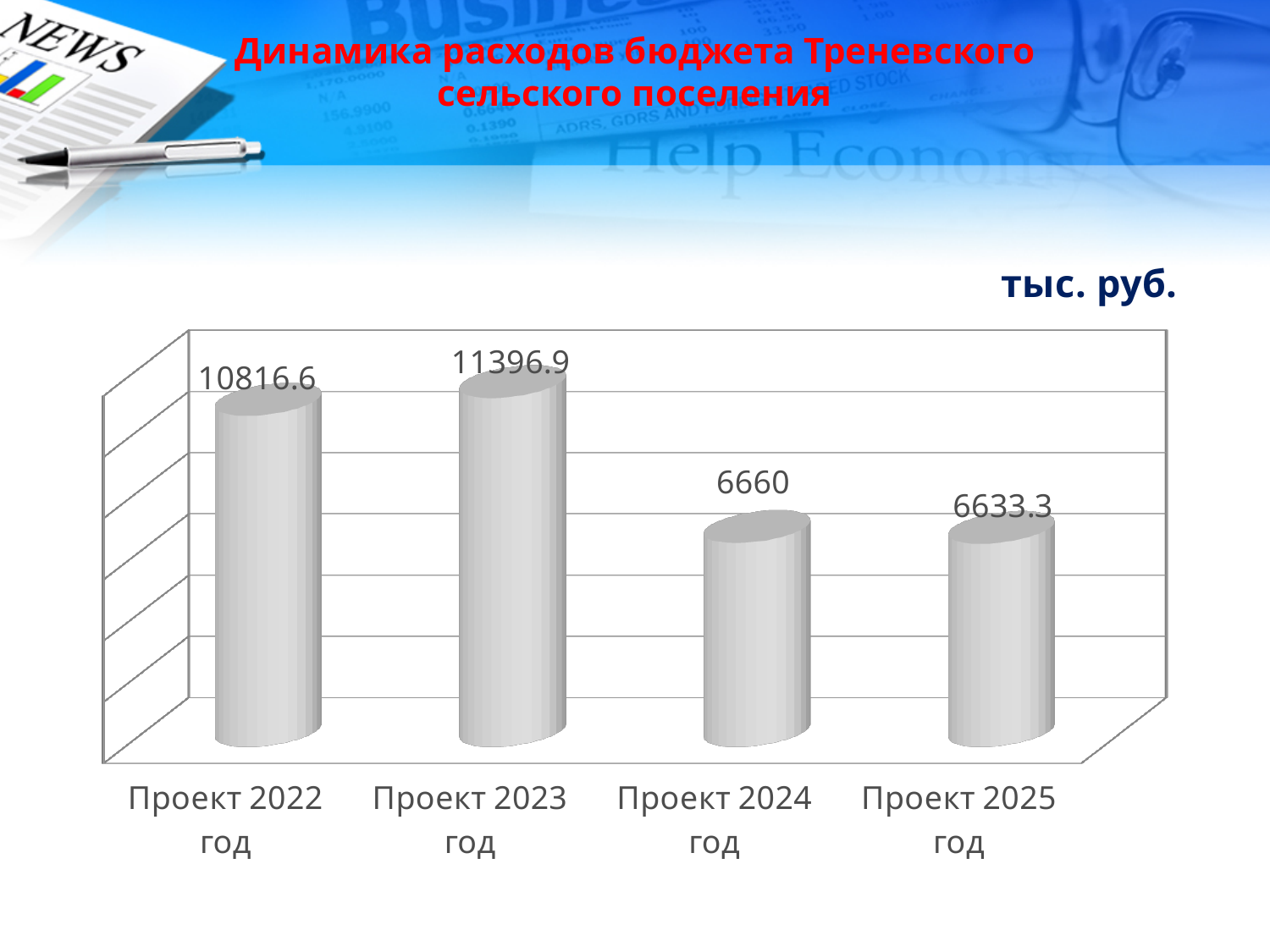
What is the difference between the values for Проект 2023 год and Проект 2022 год? 580.3 What kind of chart is shown on the slide? Bar chart What is the difference between the values for Проект 2023 год and Проект 2024 год? 4736.9 What is the value for Проект 2023 год? 11396.9 What is the value for Проект 2024 год? 6660 Which category has the lowest value? Проект 2025 год What is the value for Проект 2025 год? 6633.3 How many categories are shown in the chart? 4 What is the value for Проект 2022 год? 10816.6 Which category has the highest value? Проект 2023 год What unit is indicated for the chart values? тыс. руб. Which is larger, the value for Проект 2022 год or Проект 2024 год? Проект 2022 год